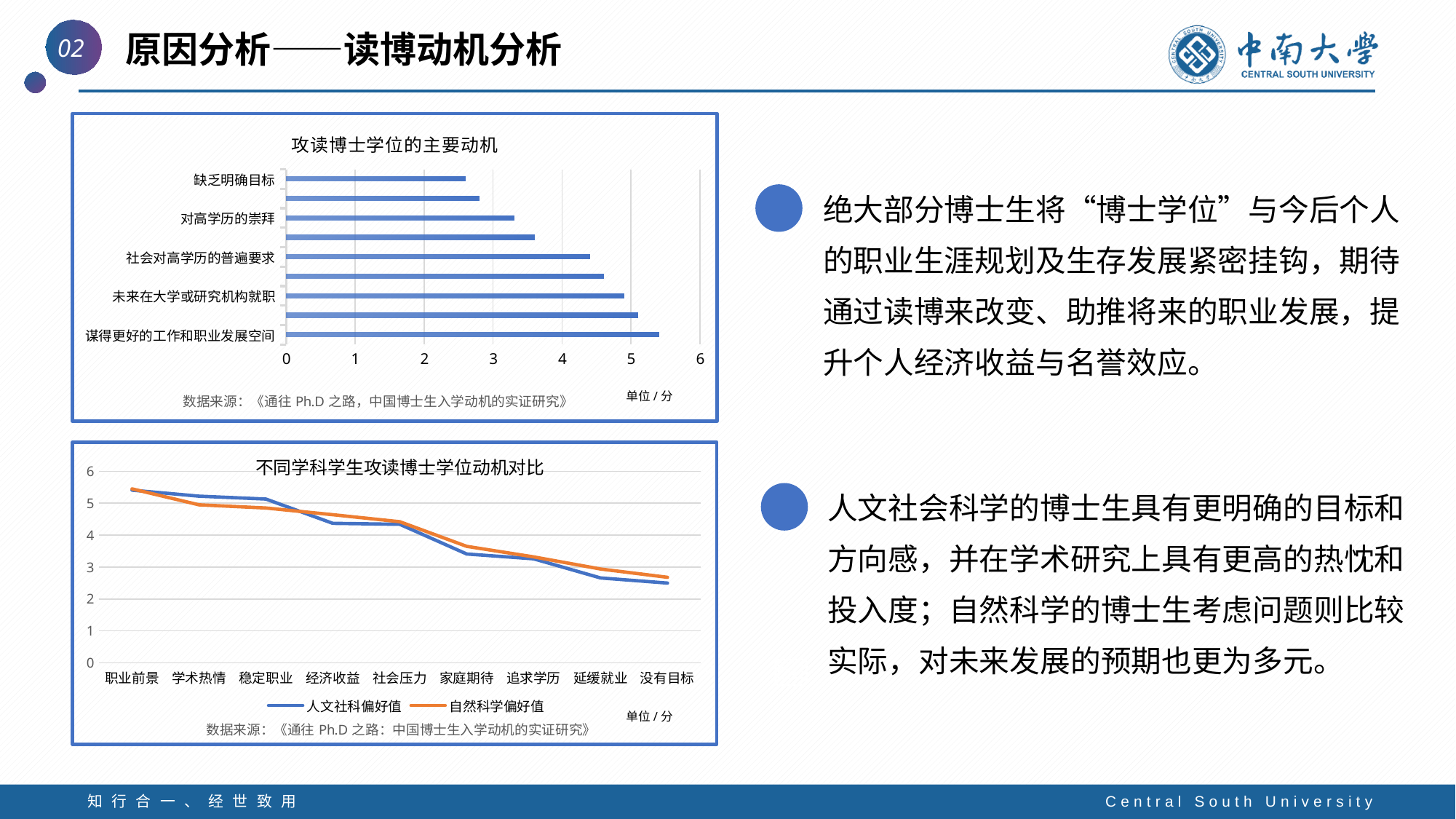
In the top chart 攻读博士学位的主要动机, is the value for 谋得更好的工作和职业发展空间 greater or less than 5? greater In the bottom chart 不同学科学生攻读博士学位动机对比, do the values of 人文社科偏好值 rise or fall from 职业前景 to 没有目标? fall In the top chart 攻读博士学位的主要动机, is the value for 缺乏明确目标 greater or less than 3? less In the bottom chart 不同学科学生攻读博士学位动机对比, which series has the higher value at 学术热情? 人文社科偏好值 How many categories are shown on the x axis of the bottom chart 不同学科学生攻读博士学位动机对比? 9 In the top chart 攻读博士学位的主要动机, which labelled motivation has the longest bar? 谋得更好的工作和职业发展空间 In the top chart 攻读博士学位的主要动机, which labelled motivation has the shortest bar? 缺乏明确目标 How many bars are plotted in the top chart 攻读博士学位的主要动机? 9 In the top chart 攻读博士学位的主要动机, which is larger: the value for 对高学历的崇拜 or the value for 社会对高学历的普遍要求? 社会对高学历的普遍要求 What kind of chart is the bottom chart titled 不同学科学生攻读博士学位动机对比? line chart How many series does the legend of the bottom chart 不同学科学生攻读博士学位动机对比 list? 2 What kind of chart is the top chart titled 攻读博士学位的主要动机? bar chart